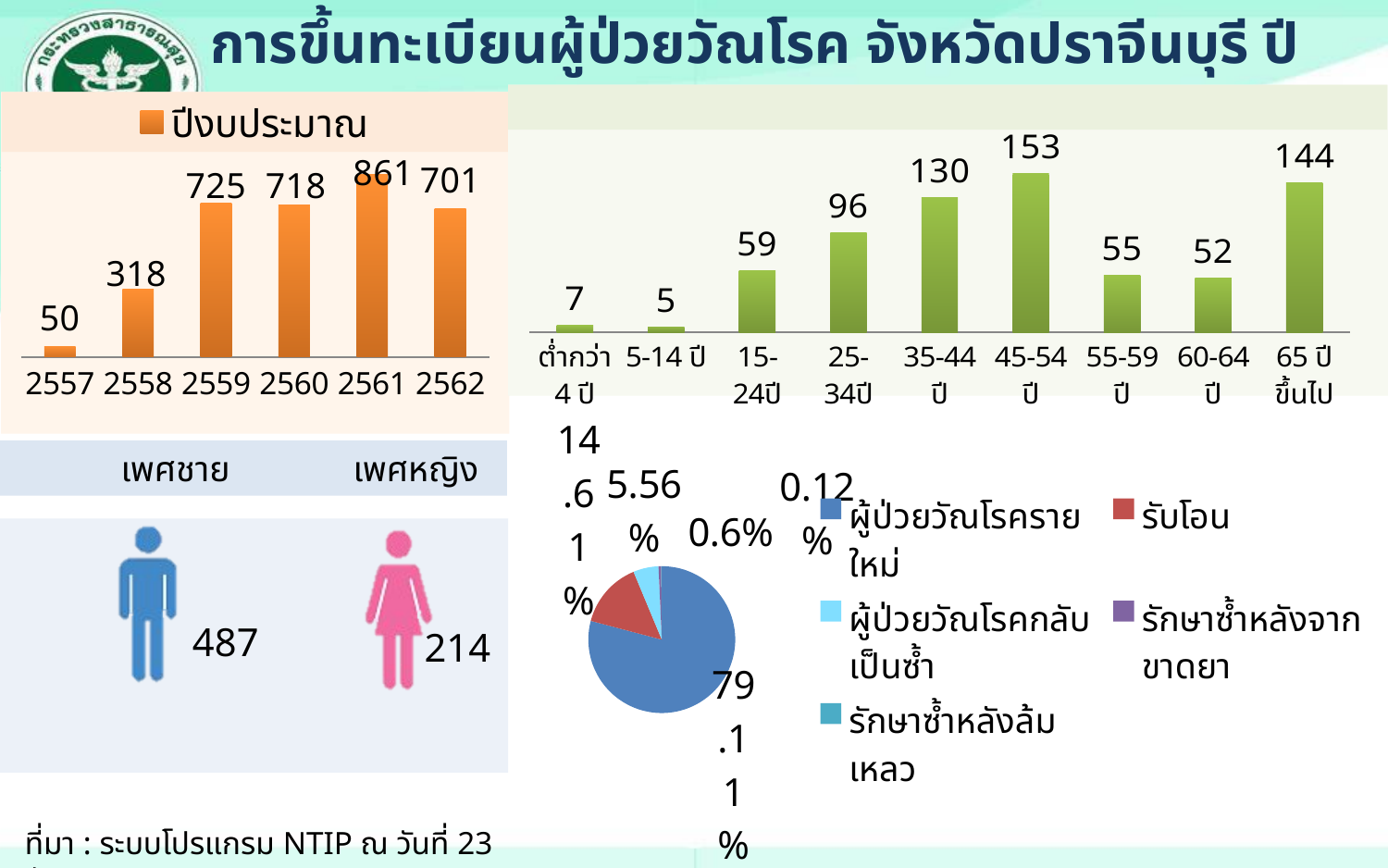
In the top-right bar chart by age group, what is the difference between the values for 25-34ปี and 15-24ปี? 37 In the top-left bar chart (ปีงบประมาณ), how many years are shown on the x axis? 6 In the top-left bar chart (ปีงบประมาณ), what is the difference between the values for 2559 and 2558? 407 In the top-right bar chart by age group, which is larger, the value for 35-44 ปี or the value for 65 ปีขึ้นไป? 65 ปีขึ้นไป In the top-right bar chart by age group, how many age groups are shown? 9 In the top-left bar chart (ปีงบประมาณ), which year has the highest value? 2561 In the top-right bar chart by age group, what is the value for 45-54 ปี? 153 In the bottom pie chart, what share does the largest slice (ผู้ป่วยวัณโรครายใหม่) have? 79.11% In the top-left bar chart (ปีงบประมาณ), which year has the lowest value? 2557 In the top-left bar chart (ปีงบประมาณ), what is the value for 2561? 861 In the top-right bar chart by age group, which age group has the lowest value? 5-14 ปี What kind of chart is the bottom chart with the legend ผู้ป่วยวัณโรครายใหม่? pie chart